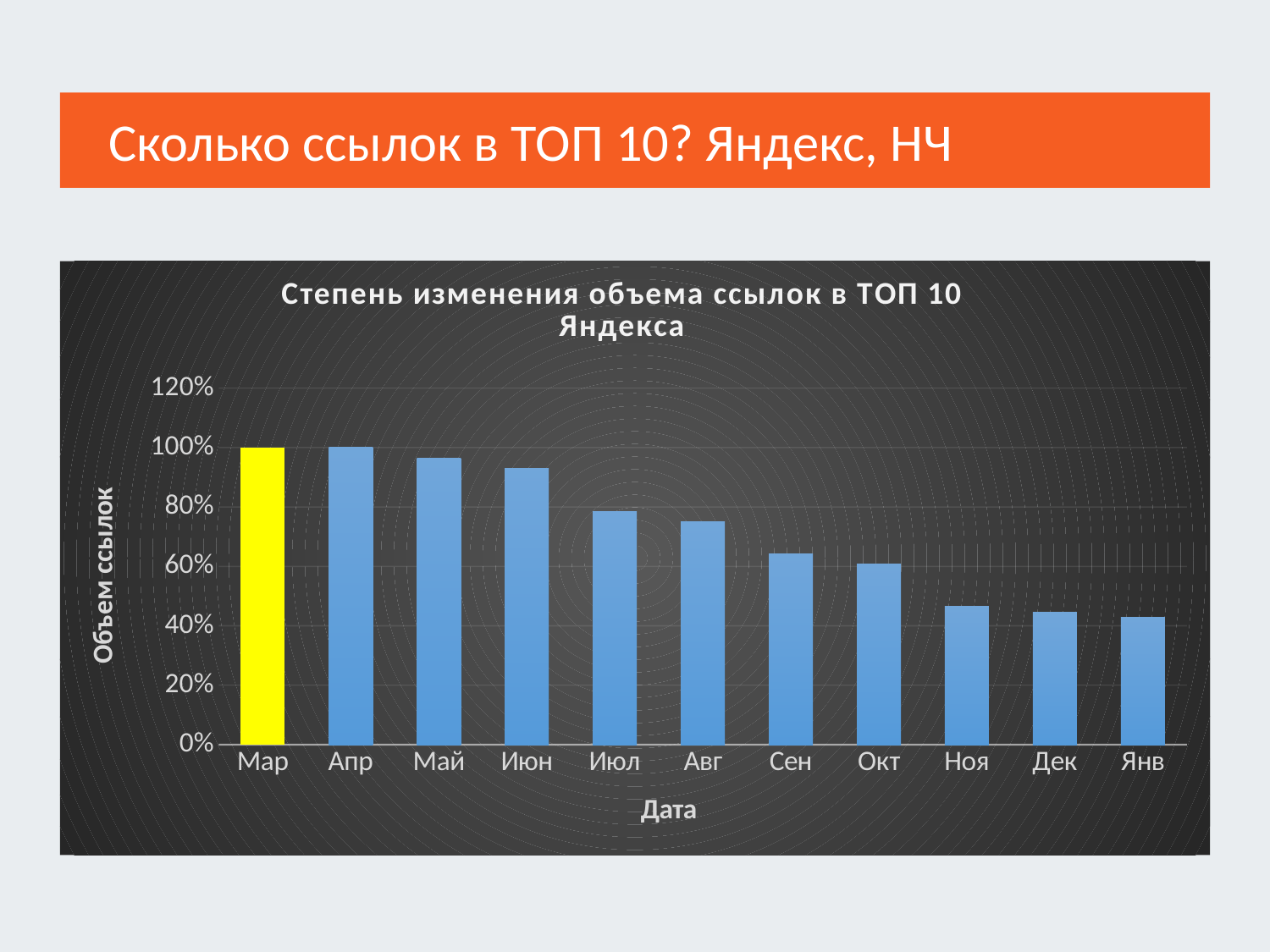
Which is larger, the value for Авг or the value for Ноя? Авг Is the value for Май greater or less than 80%? greater Is the value for Ноя greater or less than 60%? less How many months are shown on the x axis of the chart? 11 What is the title of the chart? Степень изменения объема ссылок в ТОП 10 Яндекса Is the value for Июл greater or less than 60%? greater Which is larger, the value for Июн or the value for Сен? Июн Do the values rise or fall from Мар to Янв along the x axis? fall What is the value for Мар? 100% What kind of chart is shown on the slide? bar chart Which month's bar is coloured yellow? Мар